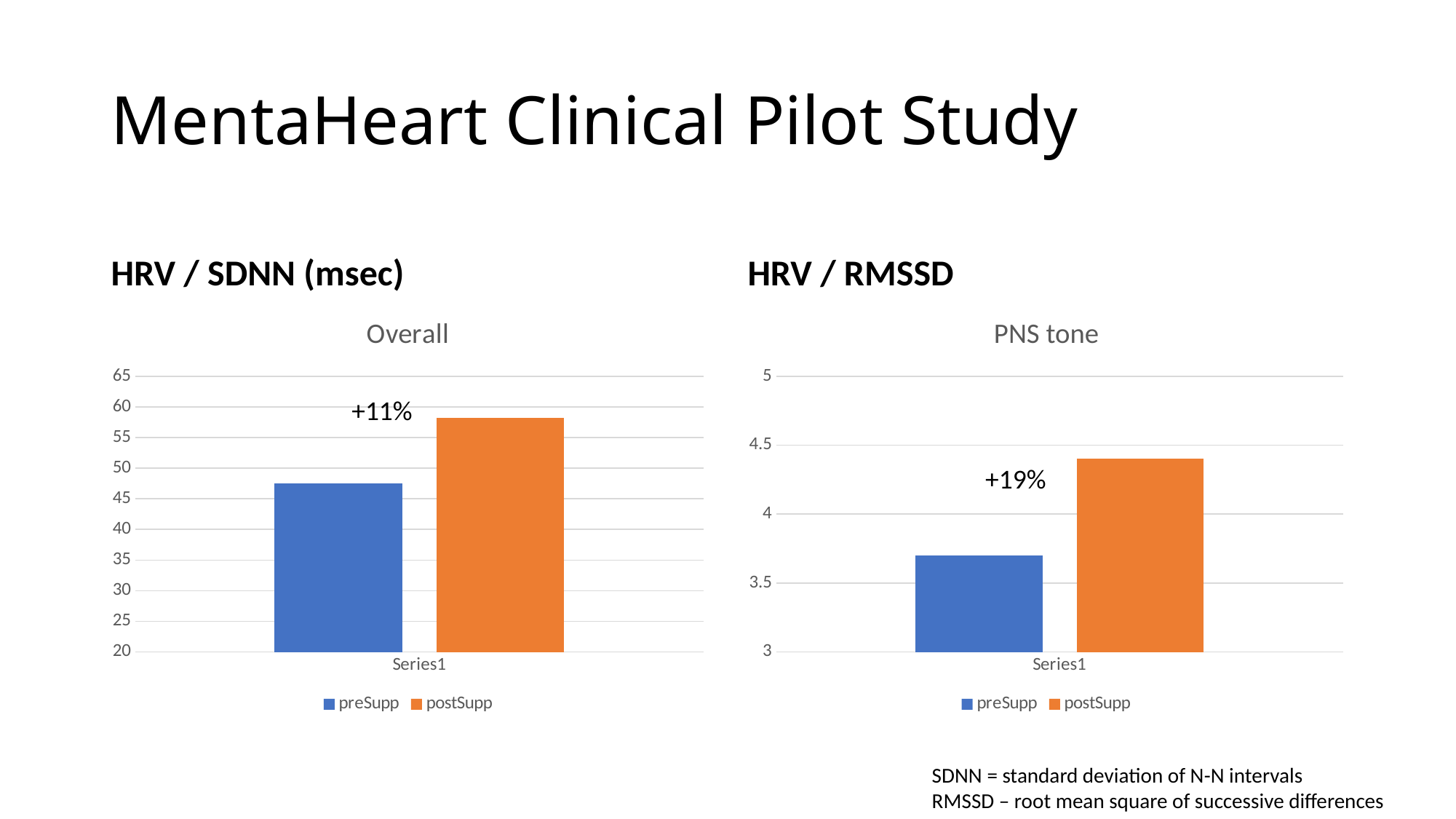
In the "Overall" chart, which series has the taller bar, preSupp or postSupp? postSupp In the "Overall" chart, is the value for preSupp greater or less than 50? less In the "PNS tone" chart, is the value for postSupp greater or less than 4? greater In the "PNS tone" chart, is the value for preSupp greater or less than 4? less What kind of chart is the "PNS tone" chart on the right? bar chart What kind of chart is the "Overall" chart on the left? bar chart In the "Overall" chart, how many series does the legend list? 2 In the "PNS tone" chart, what percentage change is annotated between the preSupp and postSupp bars? +19% In the "Overall" chart, what percentage change is annotated between the preSupp and postSupp bars? +11% In the "PNS tone" chart, which series has the shorter bar, preSupp or postSupp? preSupp In the "PNS tone" chart, how many series does the legend list? 2